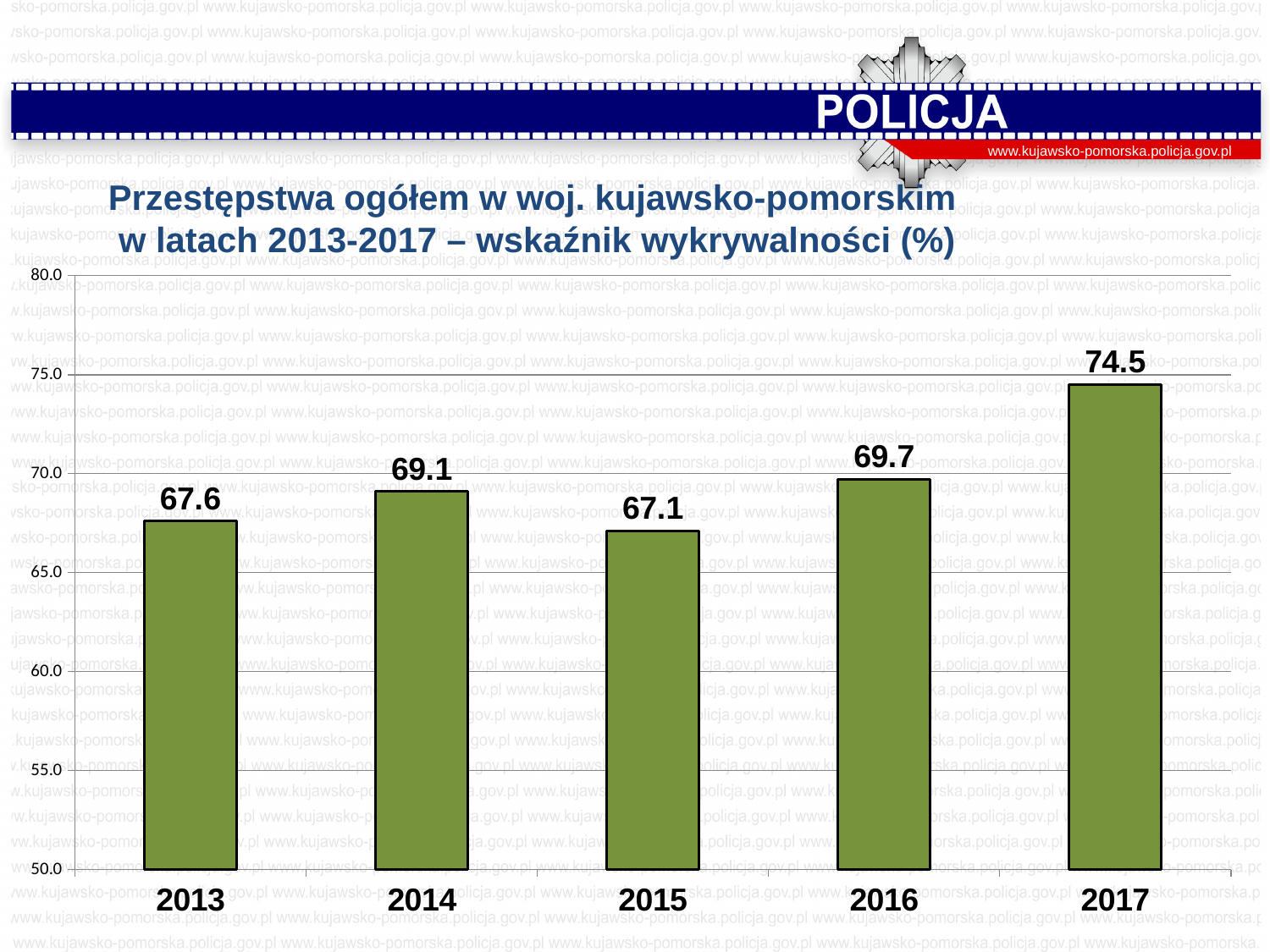
Which year has the lowest value? 2015 What is the difference between the values for 2017 and 2016? 4.8 Is the value for 2016 greater or less than 70.0? less What is the value shown for 2013? 67.6 How many years are shown on the x axis? 5 Which year has the highest value? 2017 Which is larger, the value for 2014 or the value for 2016? 2016 What kind of chart is shown on the slide? bar chart What is the title of the chart? Przestępstwa ogółem w woj. kujawsko-pomorskim w latach 2013-2017 – wskaźnik wykrywalności (%) What is the detection rate value shown for 2017? 74.5 What is the difference between the values for 2014 and 2013? 1.5 What is the value shown for 2015? 67.1